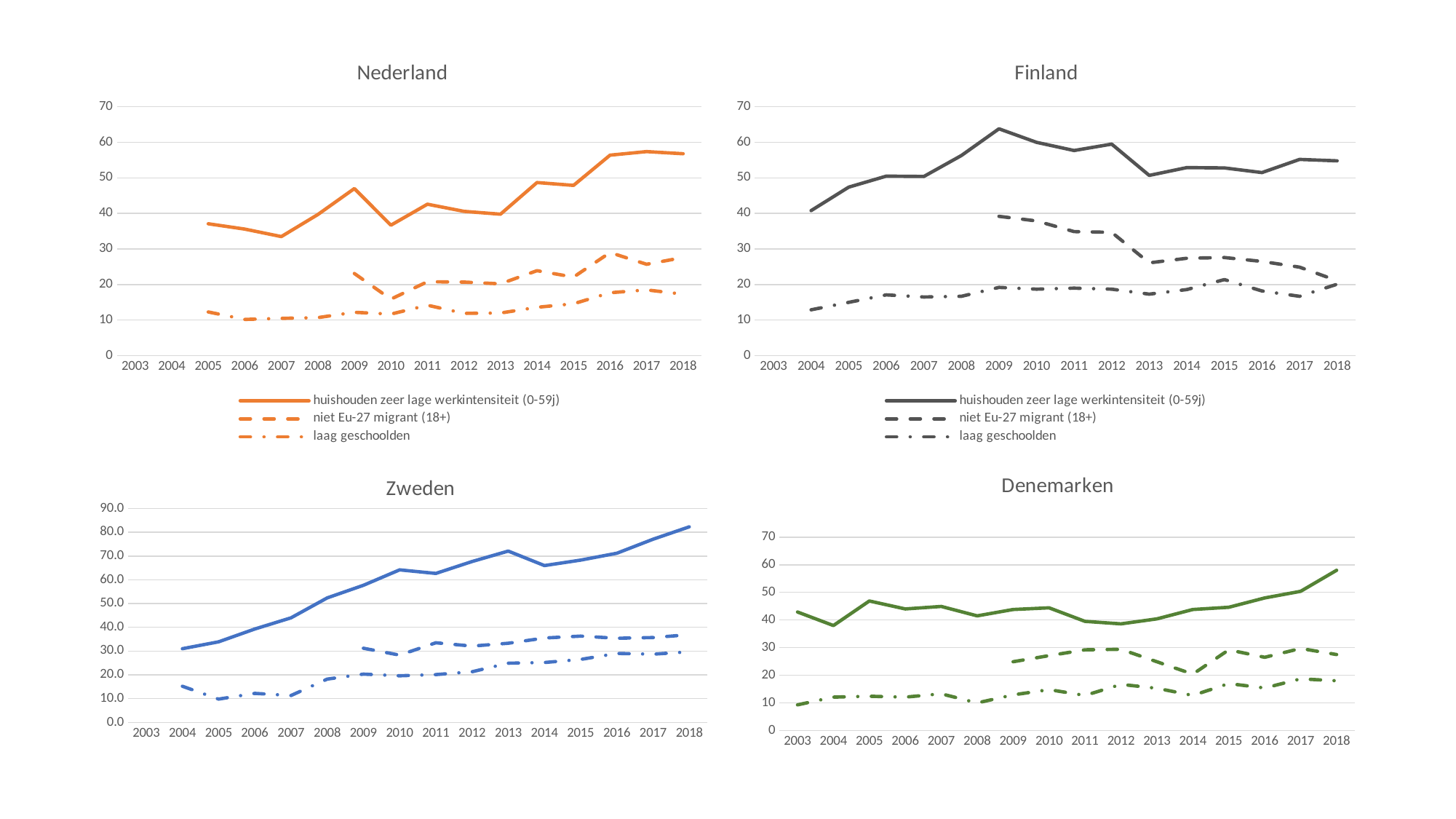
What kind of chart is the Nederland chart? line chart Which of the four charts has a y axis that goes up to 90.0? Zweden In the Nederland chart, which year has the larger value for 'huishouden zeer lage werkintensiteit (0-59j)': 2005 or 2018? 2018 In the Denemarken chart, in which year is the solid line at its highest? 2018 In the Nederland chart, is the 2007 value of 'huishouden zeer lage werkintensiteit (0-59j)' greater or less than 40? less In the Zweden chart, is the 2018 value of the solid line greater or less than 70.0? greater In the Finland chart, is the 2009 value of 'huishouden zeer lage werkintensiteit (0-59j)' greater or less than 60? greater In the Finland chart, in which year does the 'huishouden zeer lage werkintensiteit (0-59j)' line reach its highest value? 2009 How many series does the legend of the Nederland chart list? 3 In the Zweden chart, does the solid line rise or fall from 2004 to 2018? rise